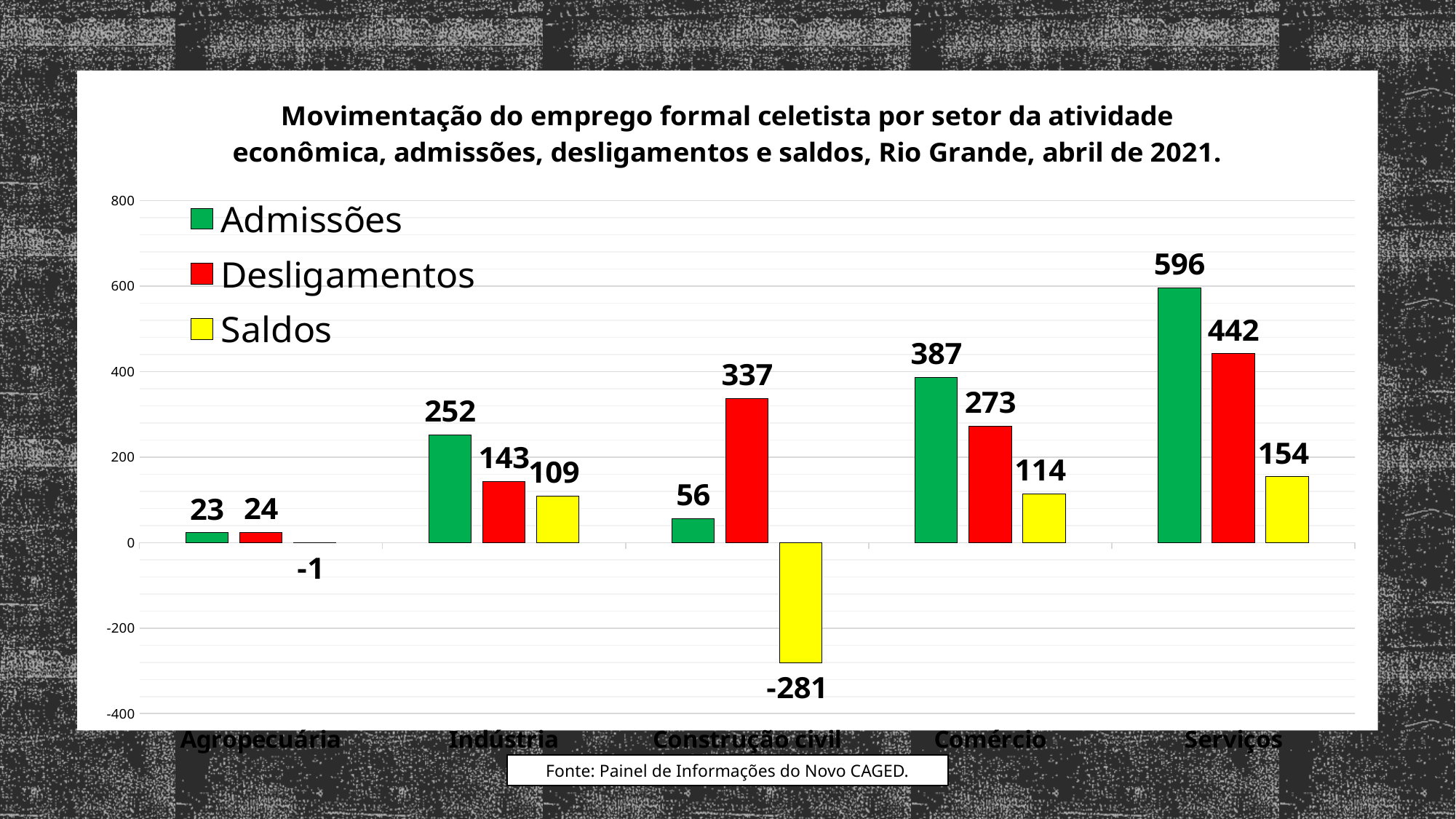
Which sector has the lowest Saldos value? Construção civil Which sector has the highest Admissões value? Serviços What colour represents the Saldos series? yellow How many sectors are shown on the x axis? 5 What is the value of Admissões for Serviços? 596 What is the difference between Admissões and Desligamentos for Indústria? 109 What is the value of Saldos for Construção civil? -281 How many series does the legend list? 3 What is the value of Desligamentos for Comércio? 273 What kind of chart is shown on the slide? bar chart Is the Desligamentos value for Serviços greater or less than 400? greater Which is larger for Construção civil, Admissões or Desligamentos? Desligamentos